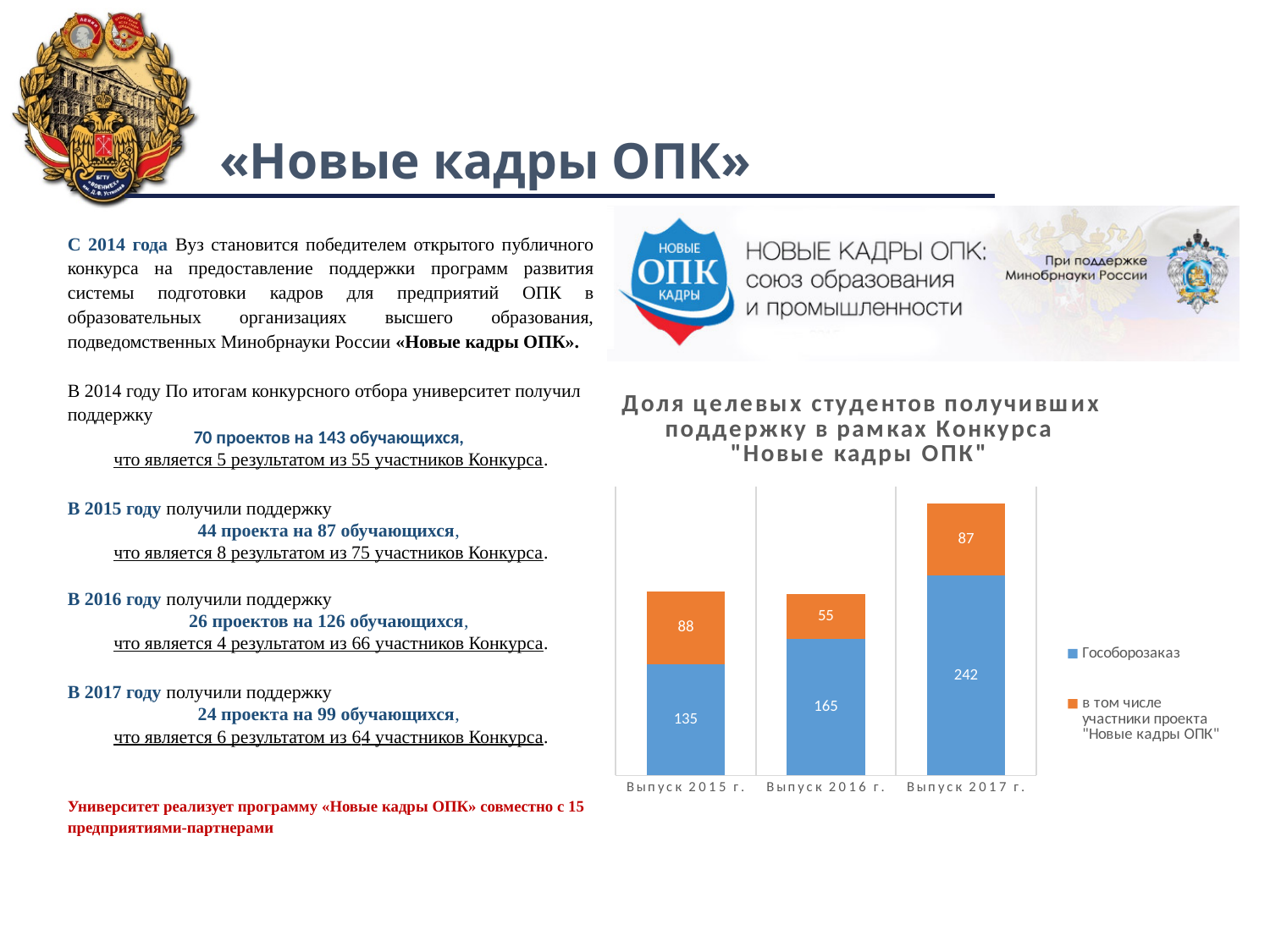
What is the total of the stacked bar for Выпуск 2015 г.? 223 Which category has the lowest value for the series 'в том числе участники проекта "Новые кадры ОПК"'? Выпуск 2016 г. What is the difference between the Гособорозаказ values for Выпуск 2017 г. and Выпуск 2016 г.? 77 Which is larger: the 'в том числе участники проекта "Новые кадры ОПК"' value for Выпуск 2015 г. or for Выпуск 2017 г.? Выпуск 2015 г. What is the value of the series 'в том числе участники проекта "Новые кадры ОПК"' for Выпуск 2016 г.? 55 What type of chart is shown on the slide? Stacked bar chart What is the value of the Гособорозаказ series for Выпуск 2015 г.? 135 What is the total of the stacked bar for Выпуск 2017 г.? 329 Which category has the highest Гособорозаказ value? Выпуск 2017 г. What is the value of the Гособорозаказ series for Выпуск 2017 г.? 242 How many series does the chart legend list? 2 How many categories are shown on the x axis of the chart? 3